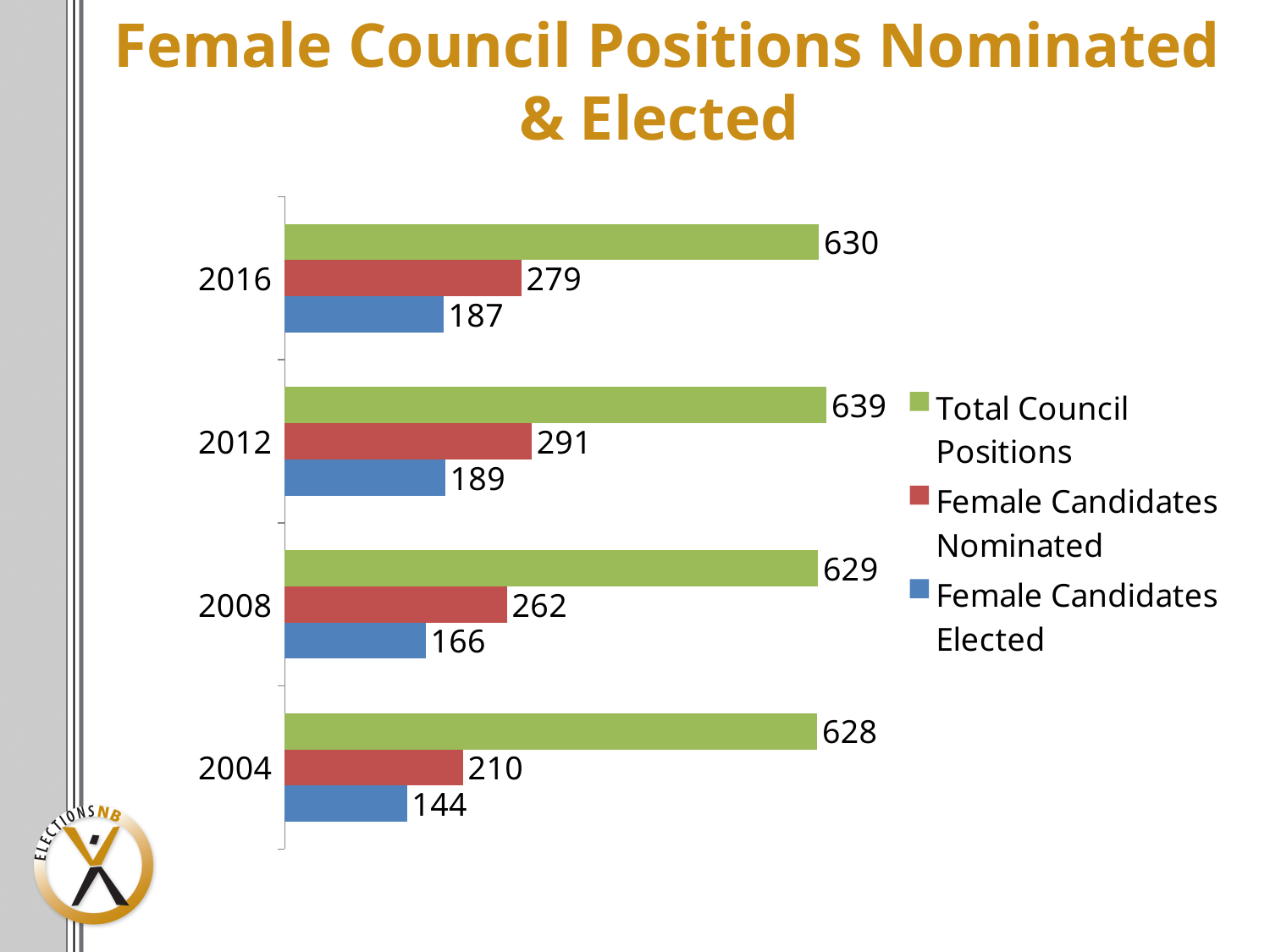
In which year was the number of Female Candidates Elected highest? 2012 What is the value for Female Candidates Nominated in 2012? 291 Which is larger: Female Candidates Elected in 2016 or in 2008? 2016 What kind of chart is shown on the slide? Bar chart Which series is shown in green? Total Council Positions What is the value for Female Candidates Elected in 2004? 144 In which year was the number of Female Candidates Nominated lowest? 2004 What is the value for Total Council Positions in 2016? 630 How many series does the legend list? 3 How many years are shown on the chart? 4 What is the difference between Female Candidates Nominated and Female Candidates Elected in 2008? 96 What is the title of the slide? Female Council Positions Nominated & Elected